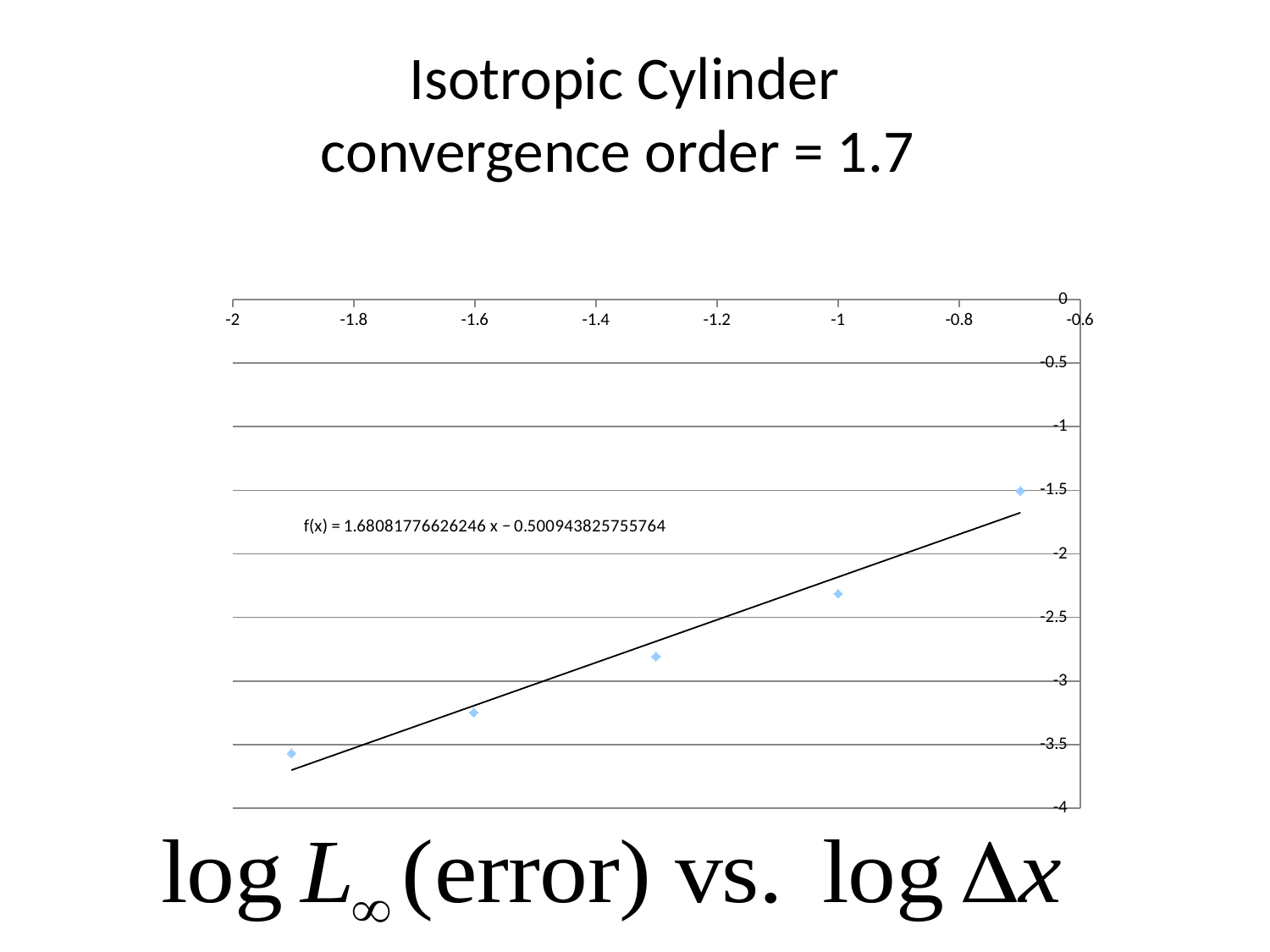
Is the value of the leftmost data point (near x = -1.9) greater or less than -3.5? less Which is higher: the data point near x = -1 or the data point near x = -1.3? The point near x = -1 What is the trendline equation printed on the chart? f(x) = 1.68081776626246 x − 0.500943825755764 Is the value of the data point near x = -1.3 greater or less than -2.5? less Which data point has the highest y value? The rightmost point (near x = -0.7) Do the plotted values rise or fall as you move from left to right along the x axis? Rise How many data points are plotted on the chart? 5 What convergence order is stated in the slide title? 1.7 Is the value of the data point near x = -1 greater or less than -2.5? greater Which data point has the lowest y value? The leftmost point (near x = -1.9) What kind of chart is shown on the slide? Scatter chart with a trendline